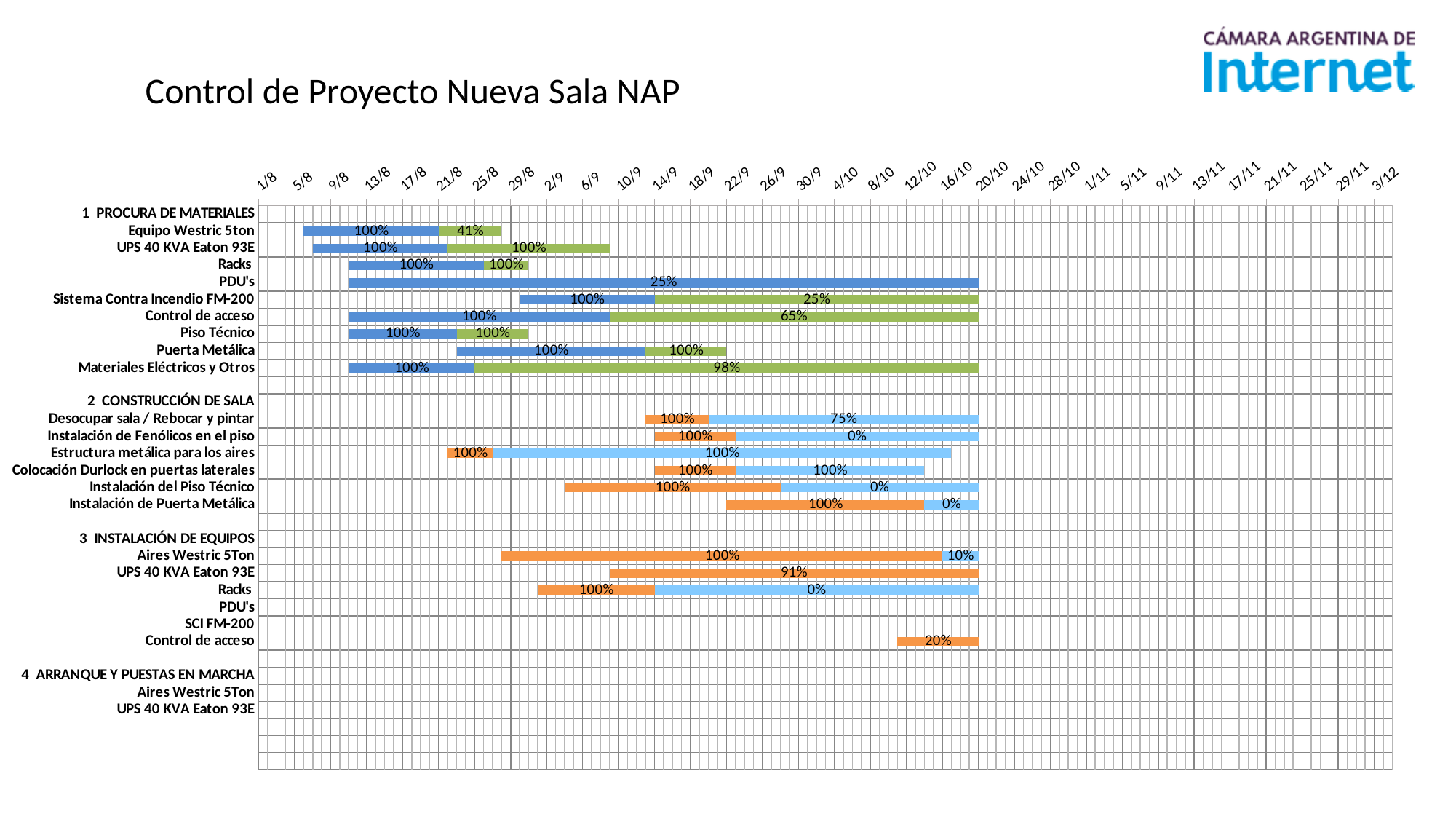
Which task in section 3 INSTALACIÓN DE EQUIPOS shows a value of 20%? Control de acceso What percentage is shown on the green bar for Equipo Westric 5Ton in section 1? 41% What percentage is shown on the green bar for Control de acceso in section 1? 65% What percentage is shown on the bar for PDU's in section 1 PROCURA DE MATERIALES? 25% What percentage is shown on the light blue bar for Desocupar sala / Rebocar y pintar? 75% What percentage is shown on the green bar for Materiales Eléctricos y Otros? 98% What is the title of the chart on the slide? Control de Proyecto Nueva Sala NAP How many numbered project phases (sections) are listed on the chart? 4 How many tasks are listed under section 1 PROCURA DE MATERIALES? 9 What percentage is shown for UPS 40 KVA Eaton 93E in section 3 INSTALACIÓN DE EQUIPOS? 91% How many tasks are listed under section 2 CONSTRUCCIÓN DE SALA? 6 What kind of chart is shown on the slide? Gantt-style horizontal bar chart